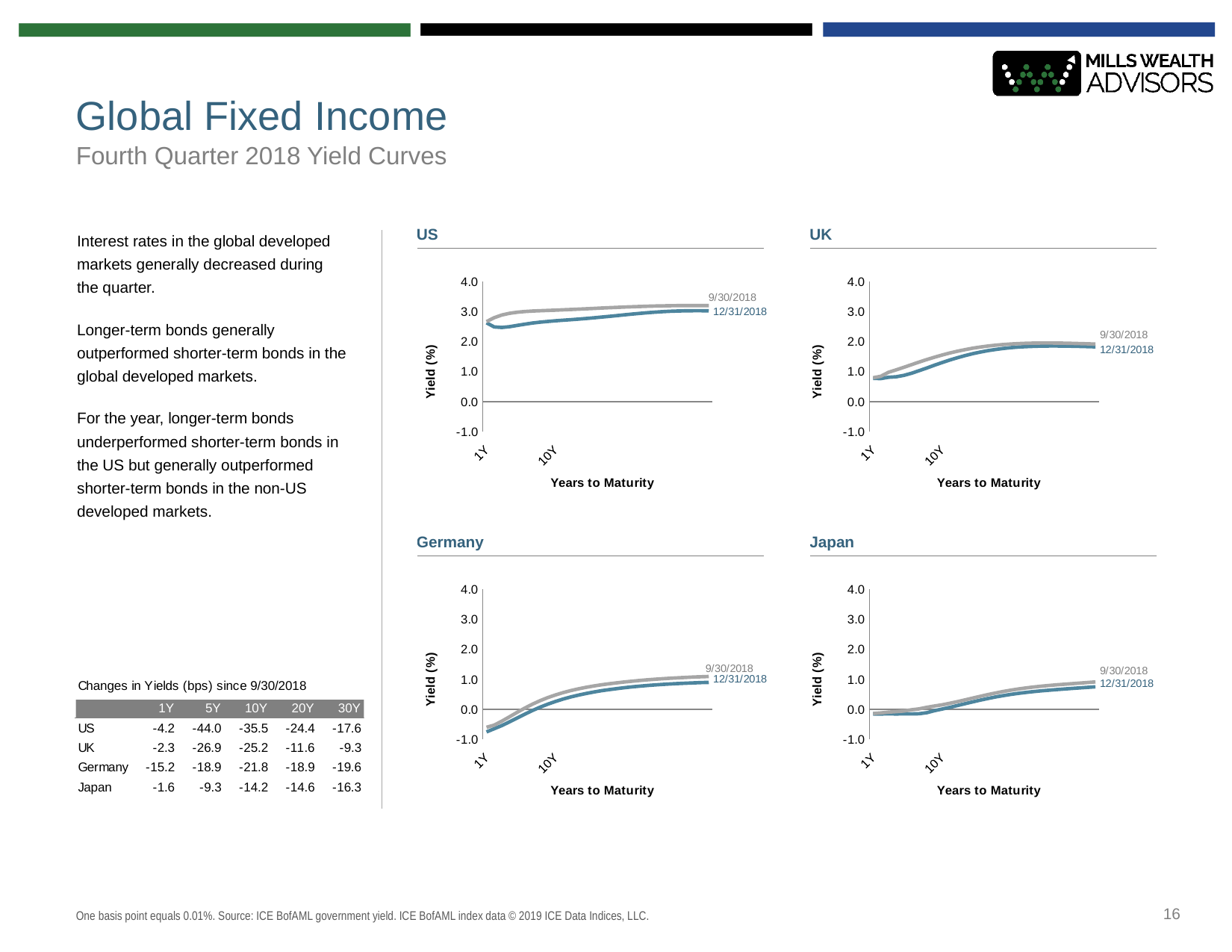
In the US chart, which series is higher at 10Y, 9/30/2018 or 12/31/2018? 9/30/2018 In the Germany chart, which series is higher at 10Y, 9/30/2018 or 12/31/2018? 9/30/2018 In the UK chart, do yields rise or fall as years to maturity increase from 1Y to 10Y? rise In the Japan chart, is the 12/31/2018 yield at 10Y greater or less than 1.0? less What is the y-axis label on the Japan chart? Yield (%) How many yield curve charts are shown on the slide? 4 What kind of chart is the US chart? line chart In the US chart, is the 12/31/2018 yield at 10Y greater or less than 2.0? greater In the Germany chart, is the 12/31/2018 yield at 1Y greater or less than 0.0? less How many series does the legend of the UK chart list? 2 What is the x-axis label on the Germany chart? Years to Maturity